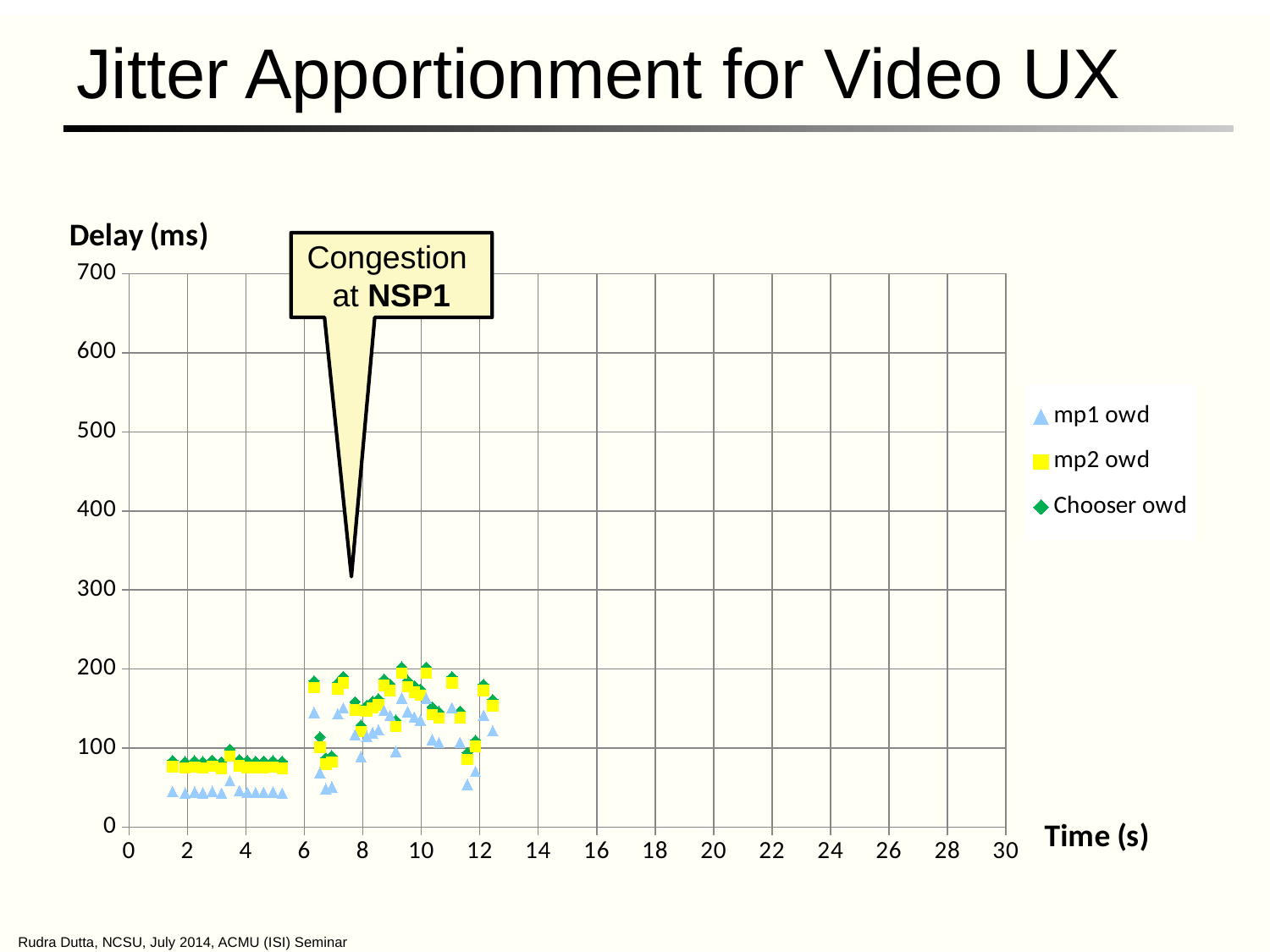
Are all plotted delay values less or greater than 300 ms? less What kind of chart is shown on the slide? scatter chart Which series has the lowest delay values between 2 s and 5 s? mp1 owd How many series does the legend list? 3 Which series has the highest delay values between 2 s and 5 s? Chooser owd Are there any data points plotted beyond 14 s on the time axis? No Is the highest Chooser owd value (around 9 s) greater or less than 100 ms? greater Do the delay values rise or fall when moving from the 2-5 s interval to the 7-12 s interval? rise What does the callout on the chart say? Congestion at NSP1 What are the three series named in the legend? mp1 owd, mp2 owd, Chooser owd At around 2 s, which is larger: the mp2 owd value or the mp1 owd value? mp2 owd Are the mp1 owd values between 2 s and 5 s greater or less than 100 ms? less